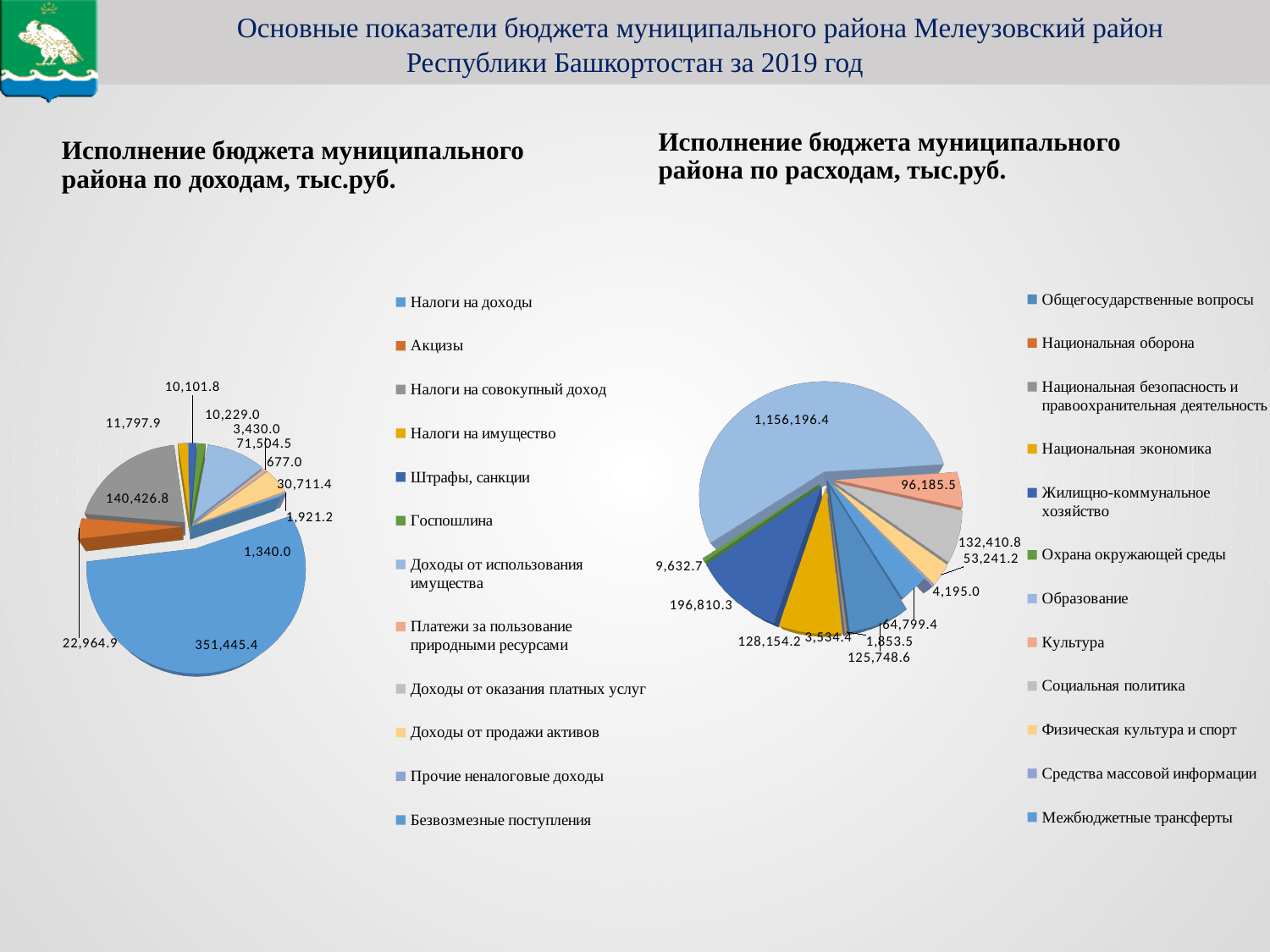
In the right chart (по расходам), what is the value for Образование? 1,156,196.4 In the left chart (по доходам), what is the largest value labelled on the pie? 351,445.4 In the right chart (по расходам), which is larger: Образование or Культура? Образование In the right chart (по расходам), what is the difference between the values for Образование and Культура? 1,060,010.9 What kind of chart is the left chart, 'Исполнение бюджета муниципального района по доходам, тыс.руб.'? pie chart How many categories does the legend of the left chart (по доходам) list? 12 What is the title of the right chart? Исполнение бюджета муниципального района по расходам, тыс.руб. In the right chart (по расходам), which category has the largest slice? Образование How many categories does the legend of the right chart (по расходам) list? 12 In the left chart (по доходам), what is the value for Акцизы? 22,964.9 In the right chart (по расходам), what is the value for Жилищно-коммунальное хозяйство? 196,810.3 In the right chart (по расходам), what is the value for Культура? 96,185.5